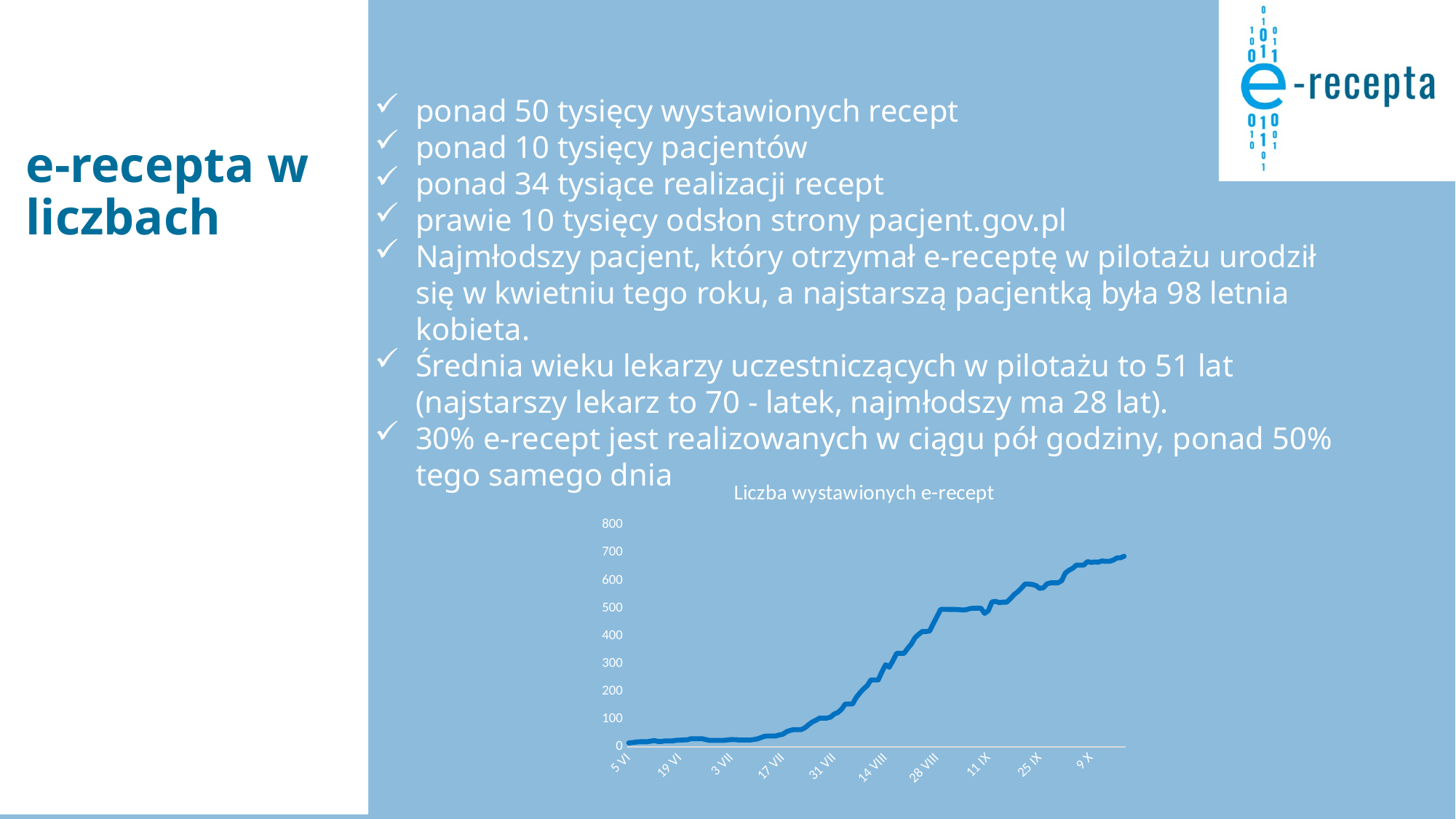
Which has the larger value, 5 VI or 9 X? 9 X What is the highest value shown on the y axis of the chart? 800 Is the value for 28 VIII greater or less than 400? greater Is the value for 31 VII greater or less than 200? less What is the title of the chart on the slide? Liczba wystawionych e-recept Is the value for 19 VI greater or less than 100? less Do the values in the chart rise or fall from left to right along the x axis? rise What kind of chart is shown on the slide? line chart How many date labels are shown on the x axis of the chart? 10 Which has the larger value, 3 VII or 11 IX? 11 IX